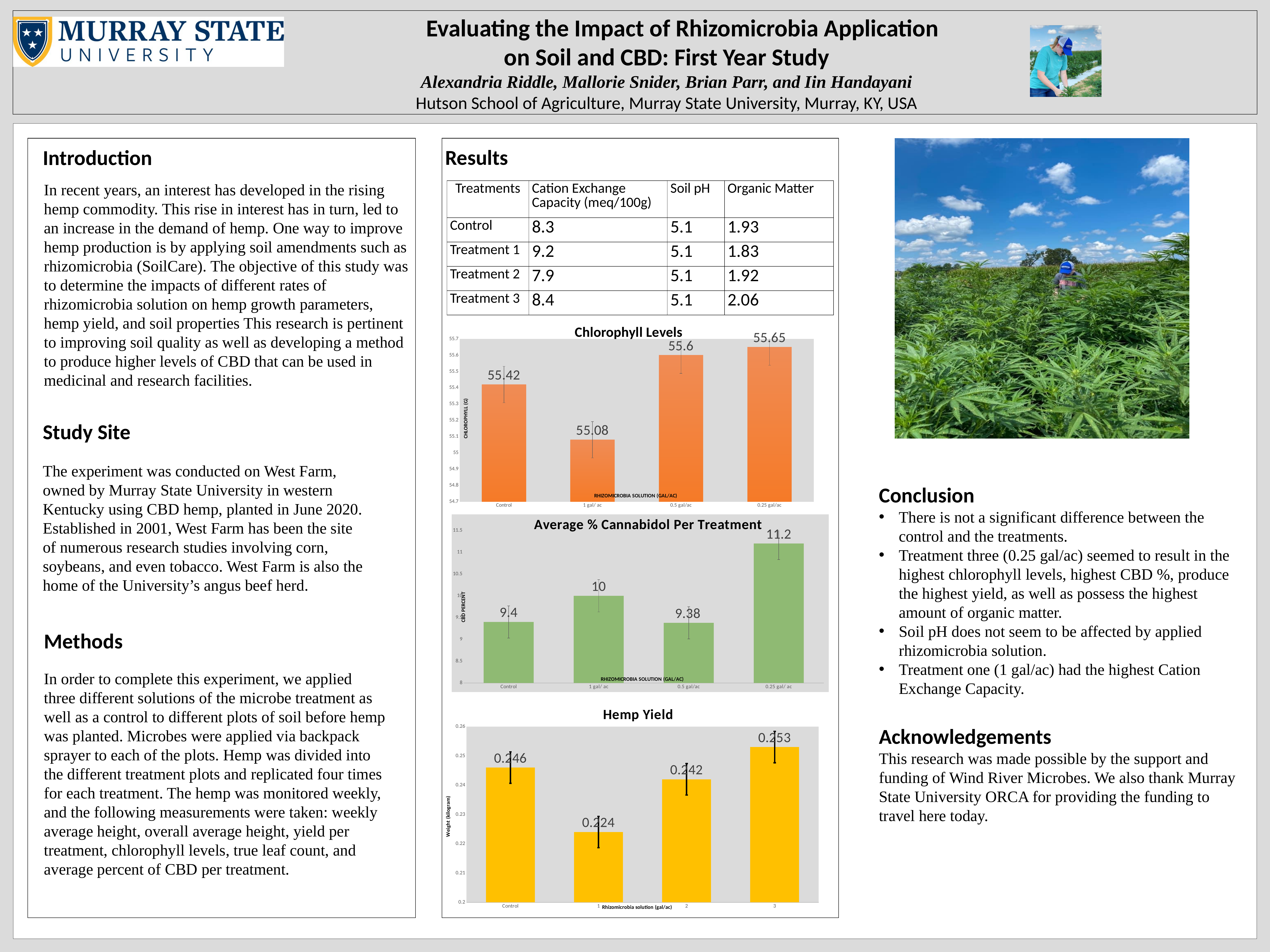
What type of chart is the Hemp Yield chart? bar chart In the Average % Cannabidol Per Treatment chart, what is the value for the 0.25 gal/ac treatment? 11.2 In the Average % Cannabidol Per Treatment chart, which treatment has the highest CBD percent? 0.25 gal/ac In the Chlorophyll Levels chart, which treatment has the lowest chlorophyll level? 1 gal/ac In the Average % Cannabidol Per Treatment chart, what is the difference between the 0.25 gal/ac value and the Control value? 1.8 In the Average % Cannabidol Per Treatment chart, is the value for the 1 gal/ac treatment larger or smaller than the Control value? larger In the Chlorophyll Levels chart, what is the difference between the 0.25 gal/ac value and the 1 gal/ac value? 0.57 In the Hemp Yield chart, what is the yield for the Control treatment? 0.246 What colour are the bars in the Average % Cannabidol Per Treatment chart? green In the Hemp Yield chart, which category has the lowest yield? 1 In the Chlorophyll Levels chart, what is the chlorophyll value for the Control treatment? 55.42 In the Chlorophyll Levels chart, how many treatment categories are plotted? 4